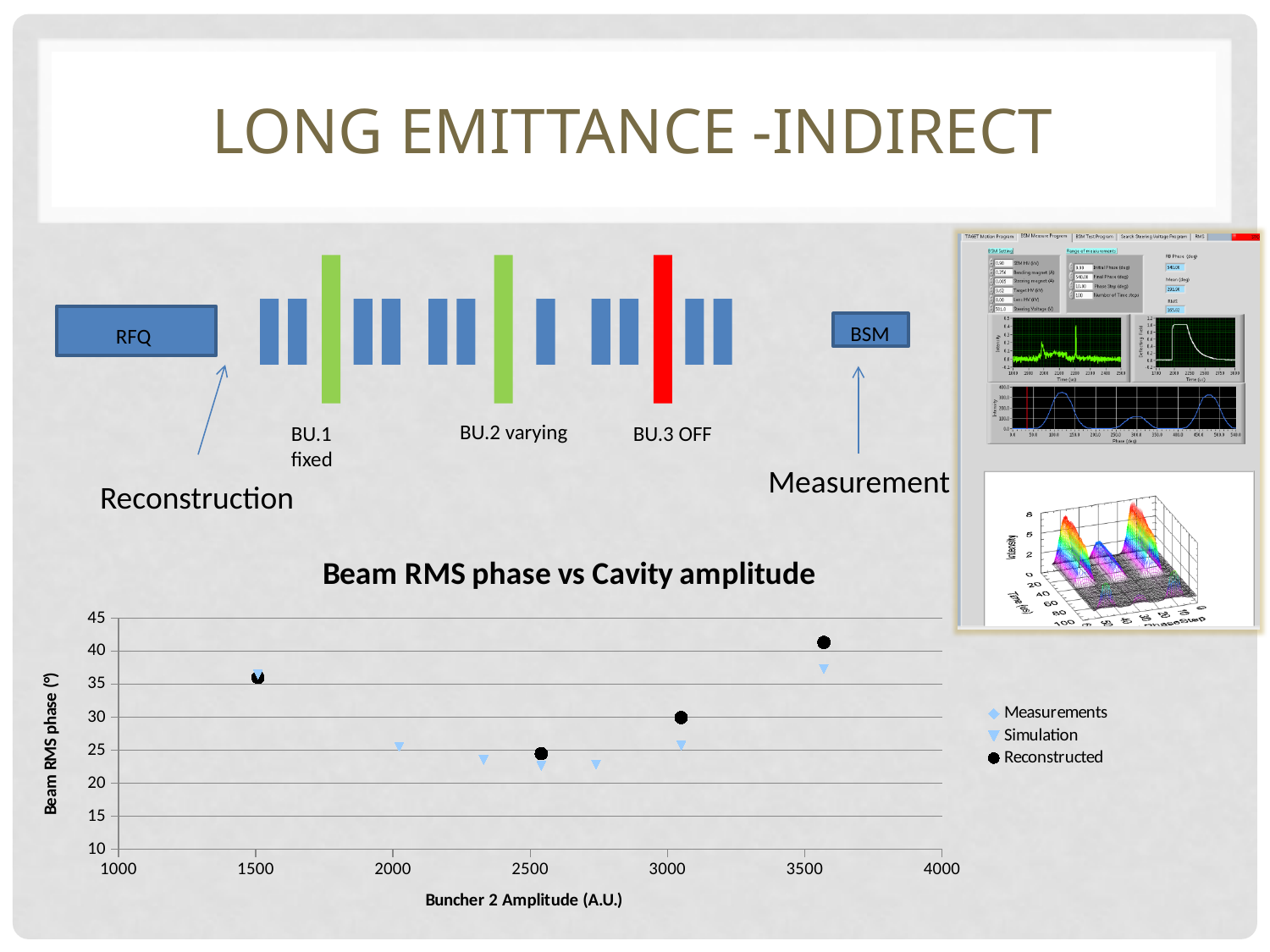
In the 'Beam RMS phase vs Cavity amplitude' chart, which series contains the highest plotted point? Reconstructed In the 'Beam RMS phase vs Cavity amplitude' chart, is the Reconstructed value near amplitude 2500 greater or less than 30? less How many Simulation (triangle) points are plotted on the 'Beam RMS phase vs Cavity amplitude' chart? 7 In the 'Beam RMS phase vs Cavity amplitude' chart, is the Reconstructed value near amplitude 3000 greater or less than 25? greater In the 'Beam RMS phase vs Cavity amplitude' chart, at the highest amplitude (near 3500), which is larger: the Reconstructed value or the Simulation value? Reconstructed What kind of chart is 'Beam RMS phase vs Cavity amplitude'? scatter chart What are the three series named in the legend of the 'Beam RMS phase vs Cavity amplitude' chart? Measurements, Simulation, Reconstructed In the 'Beam RMS phase vs Cavity amplitude' chart, is the Reconstructed value at the highest amplitude (near 3500) greater or less than 35? greater How many series does the legend of the 'Beam RMS phase vs Cavity amplitude' chart list? 3 What is the x-axis title of the 'Beam RMS phase vs Cavity amplitude' chart? Buncher 2 Amplitude (A.U.) How many Reconstructed (black circle) points are plotted on the 'Beam RMS phase vs Cavity amplitude' chart? 4